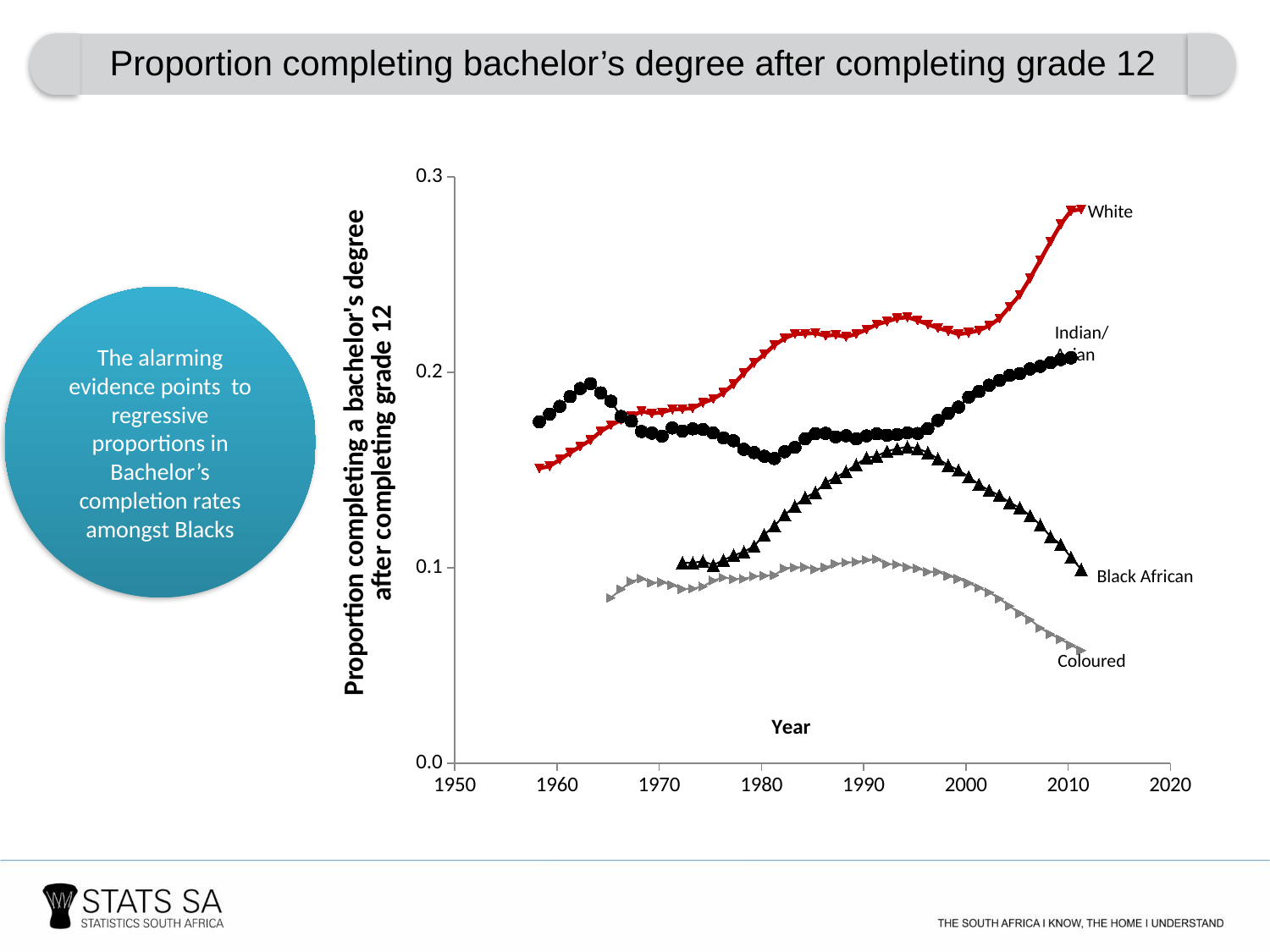
Is the value for Black African around 1995 greater or less than 0.1? greater Around 2010, which is larger: the value for Indian/Asian or the value for Black African? Indian/Asian Does the White series rise or fall between 2000 and 2010? rise Which group has the highest proportion completing a bachelor's degree around 2010? White Which group has the lowest proportion completing a bachelor's degree around 2010? Coloured Does the Coloured series rise or fall between 1990 and 2010? fall What is the label on the x axis of the chart? Year Is the value for White around 2010 greater or less than 0.2? greater Is the value for White around 1960 greater or less than 0.2? less How many population groups (series) are plotted on the chart? 4 What kind of chart is shown on the slide? line chart